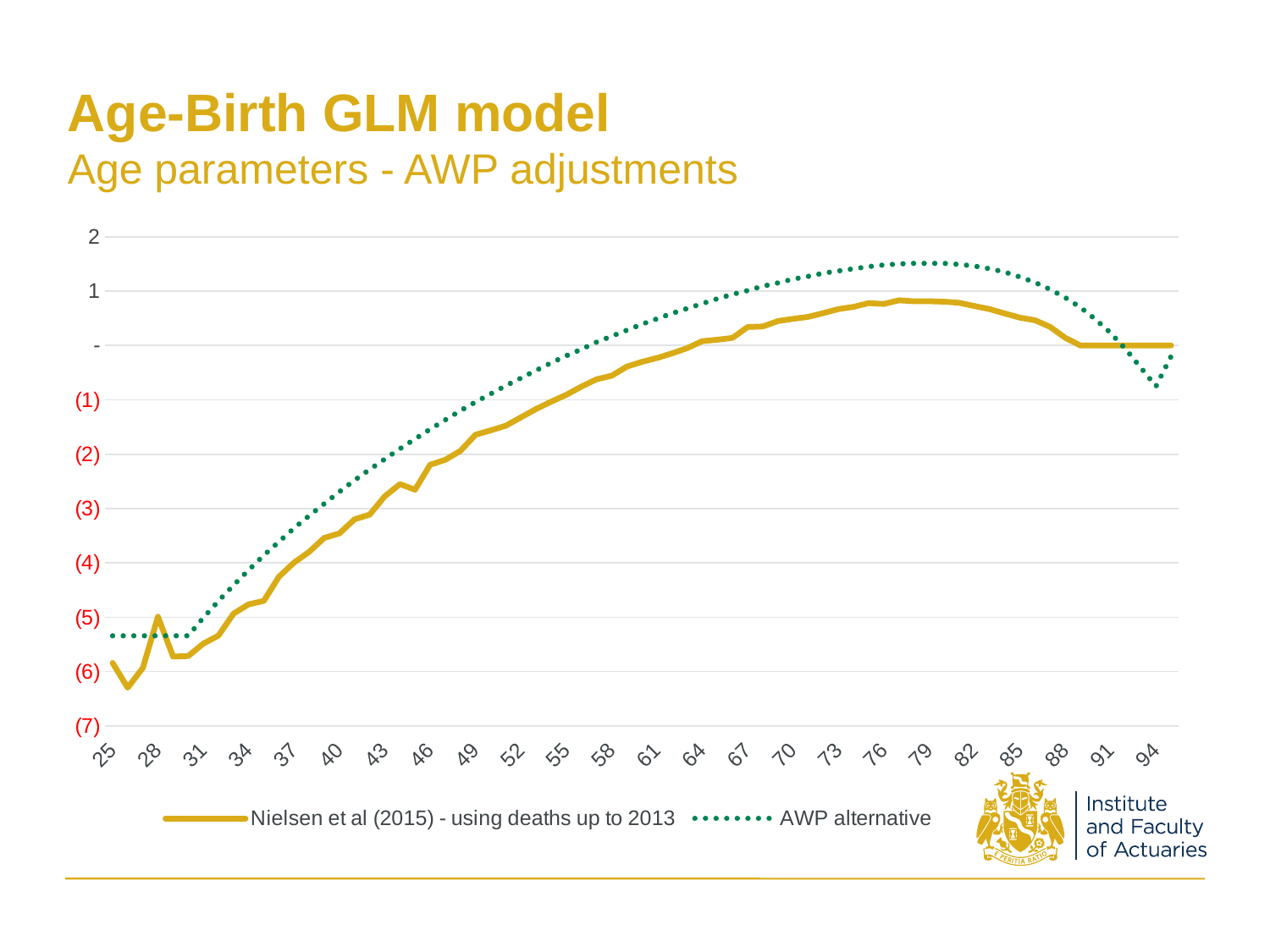
Is the value of the AWP alternative series at age 79 greater or less than 1? greater What is the title of the chart on the slide? Age-Birth GLM model Is the value of the Nielsen et al (2015) series at age 79 greater or less than 1? less Is the value of the Nielsen et al (2015) series at age 40 greater or less than (3)? less At age 94, which series has the higher value, Nielsen et al (2015) or AWP alternative? Nielsen et al (2015) - using deaths up to 2013 Does the Nielsen et al (2015) series rise or fall between age 31 and age 79? rise What kind of chart is shown on the slide? line chart Which series is drawn as a dotted green line? AWP alternative At age 79, which series has the higher value, Nielsen et al (2015) or AWP alternative? AWP alternative How many series does the legend list? 2 How many age labels are shown on the x axis? 24